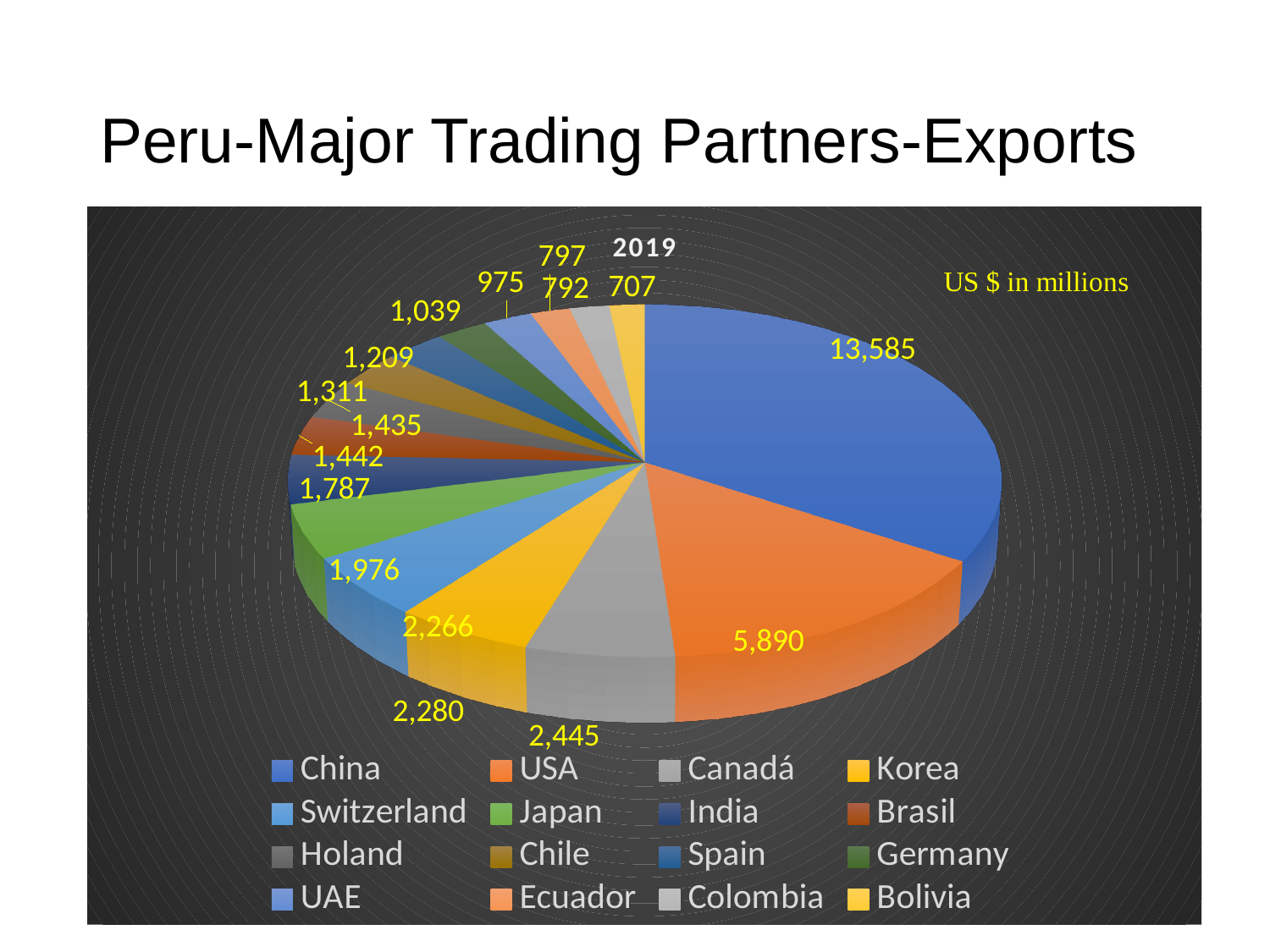
What is the value for India? 1,787 Which country has the largest slice of the pie? China What is the value for USA? 5,890 What is the difference between the values for China and USA? 7,695 How many countries are listed in the legend? 16 What is the value for Canadá? 2,445 What is the value for Japan? 1,976 Which is larger, the value for Korea or the value for Switzerland? Korea What kind of chart is shown on the slide? pie chart What is the value for China? 13,585 Which country has the smallest slice of the pie? Bolivia What unit is stated for the values in the chart? US $ in millions